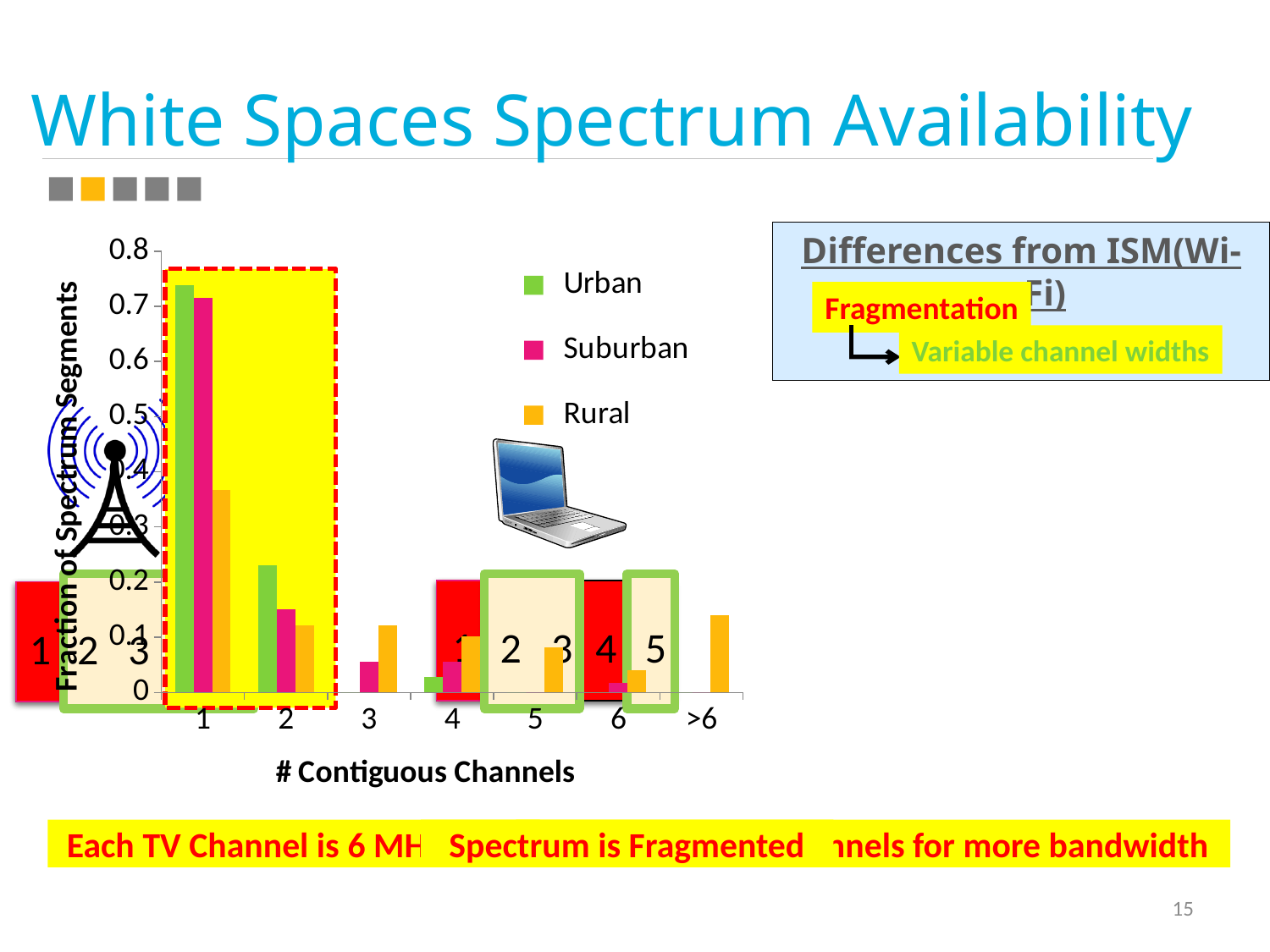
What kind of chart is shown on the slide? bar chart Is the Suburban value for 1 contiguous channel greater or less than 0.6? greater Which series has the tallest bar in the >6 category? Rural For which number of contiguous channels is the Urban value highest? 1 What is the title of the y axis of the chart? Fraction of Spectrum Segments For 1 contiguous channel, which is larger: the Urban value or the Rural value? Urban What is the title of the x axis of the chart? # Contiguous Channels Is the Rural value for 1 contiguous channel greater or less than 0.5? less How many series does the chart legend list? 3 How many categories are shown on the x axis of the chart? 7 Is the Urban value for 1 contiguous channel greater or less than 0.5? greater For 2 contiguous channels, which is larger: the Urban value or the Suburban value? Urban